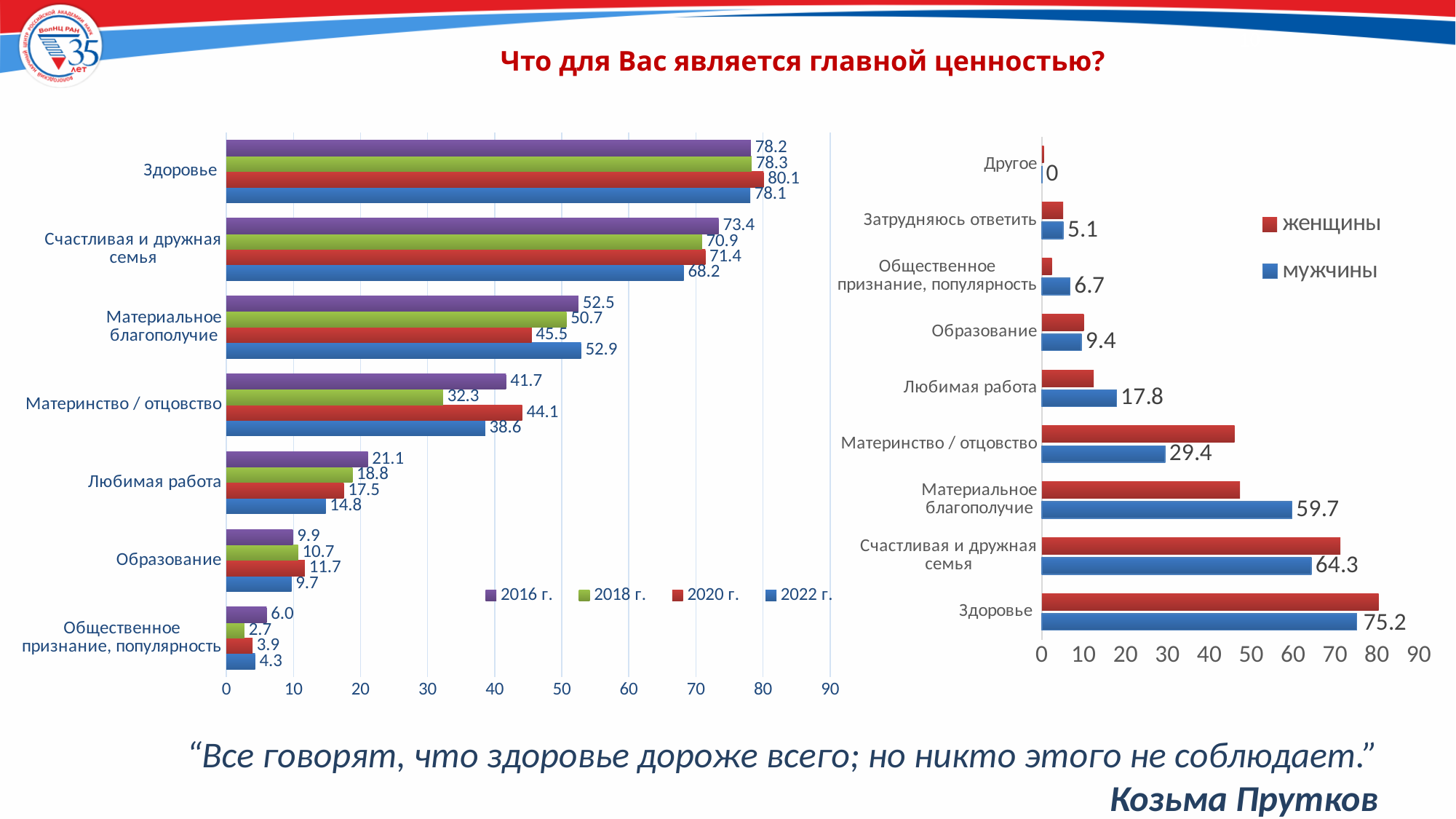
On the left chart, what is the value for Здоровье in 2020 г.? 80.1 On the left chart, do the values for Любимая работа rise or fall from 2016 г. to 2022 г.? fall On the left chart, how many categories are shown? 7 On the left chart, which category has the lowest value in 2018 г.? Общественное признание, популярность On the right chart, for Материальное благополучие, which is larger: женщины or мужчины? мужчины On the right chart, which category has the highest value for мужчины? Здоровье On the left chart, how many series does the legend list? 4 On the left chart, what is the difference between the 2016 г. and 2022 г. values for Любимая работа? 6.3 What type of chart is the right chart? bar chart On the right chart, what is the value for мужчины for Материальное благополучие? 59.7 On the left chart, what is the value for Материнство / отцовство in 2018 г.? 32.3 On the right chart, is the value for женщины for Материнство / отцовство greater or less than 40? greater